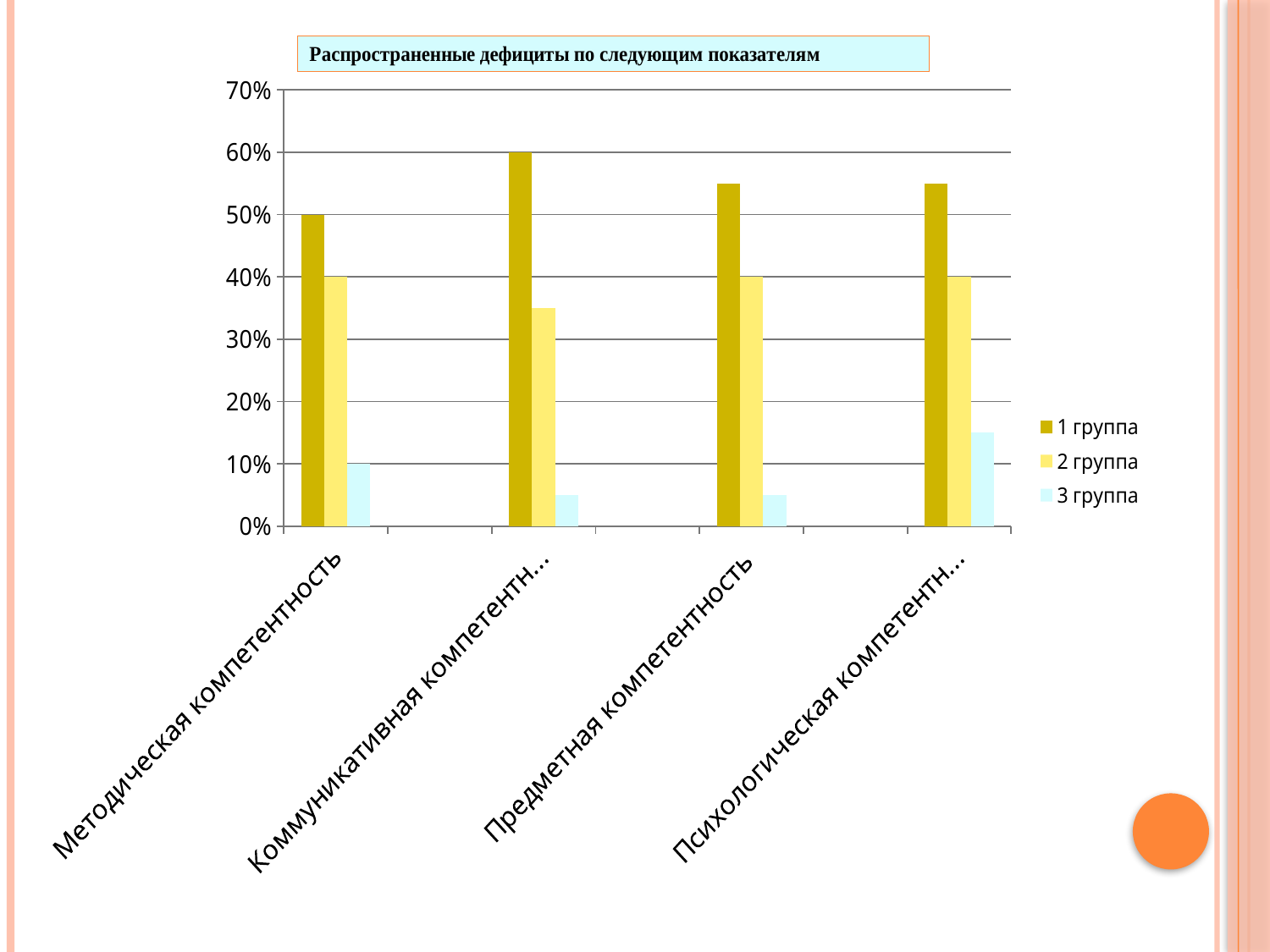
What type of chart is shown on the slide? bar chart How many categories are shown on the x axis? 4 What is the value for 1 группа in the Коммуникативная компетентность category? 60% What is the difference between the 1 группа and 2 группа values in the Методическая компетентность category? 10% What is the value for 2 группа in the Методическая компетентность category? 40% What is the value for 1 группа in the Методическая компетентность category? 50% In which category is the value for 3 группа the highest? Психологическая компетентность How many series does the legend list? 3 Is the value for 1 группа in the Предметная компетентность category greater or less than 50%? greater In which category is the value for 1 группа the highest? Коммуникативная компетентность What is the title of the chart? Распространенные дефициты по следующим показателям What is the value for 3 группа in the Методическая компетентность category? 10%